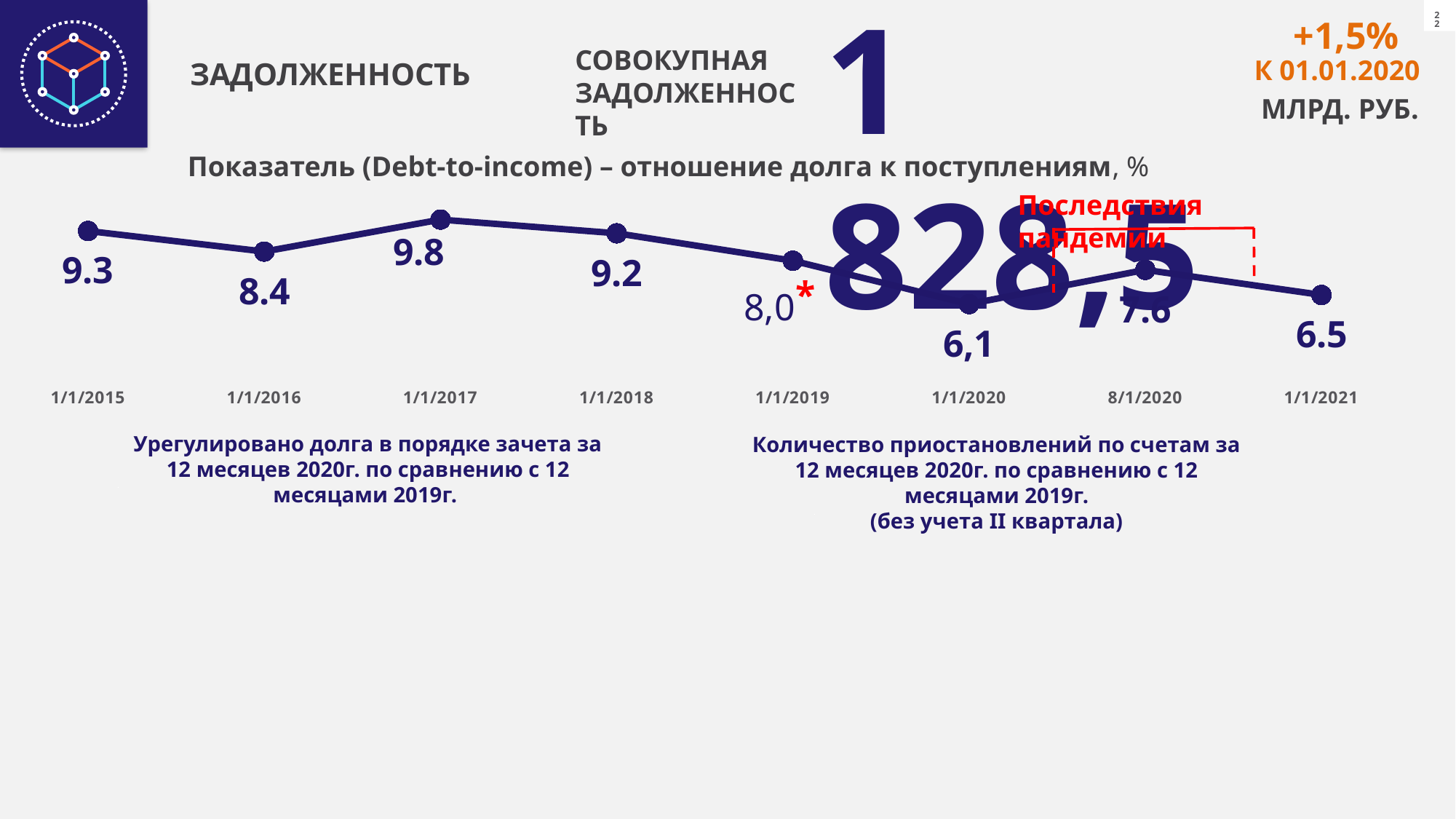
Which is larger, the value for 1/1/2018 or the value for 1/1/2019? 1/1/2018 What is the difference between the values for 1/1/2017 and 1/1/2016? 1.4 What is the value for 1/1/2021? 6.5 What is the value for 1/1/2020? 6,1 What is the value for 1/1/2017? 9.8 Which date has the highest value on the chart? 1/1/2017 Does the value overall rise or fall from 1/1/2015 to 1/1/2021? Fall What is the value for 1/1/2016? 8.4 Which date has the lowest value on the chart? 1/1/2020 What is the value for 1/1/2015? 9.3 How many data points are plotted on the chart? 8 What kind of chart is shown on the slide? Line chart